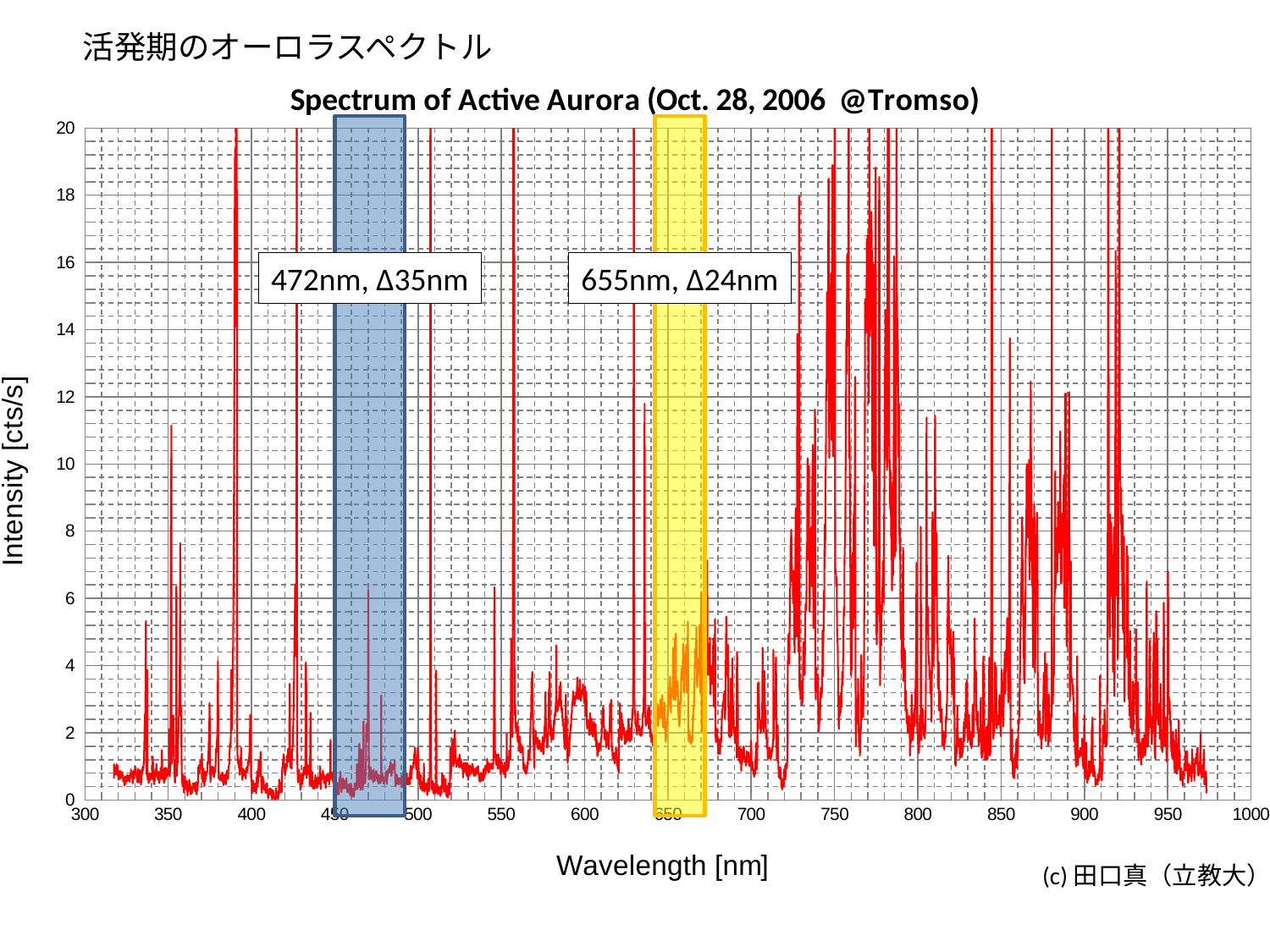
Is the intensity at 530 nm greater or less than 2? less Which is higher: the intensity near 450 nm or the peak intensity near 890 nm? the peak near 890 nm Is the intensity at 600 nm greater or less than 6? less Is the peak intensity near 770 nm greater or less than 14? greater What kind of chart is shown on the slide? line chart Which is higher: the peak intensity near 350 nm or the intensity near 600 nm? the peak near 350 nm What label is shown in the box over the yellow highlighted band? 655nm, Δ24nm What is the title of the chart? Spectrum of Active Aurora (Oct. 28, 2006 @Tromso)